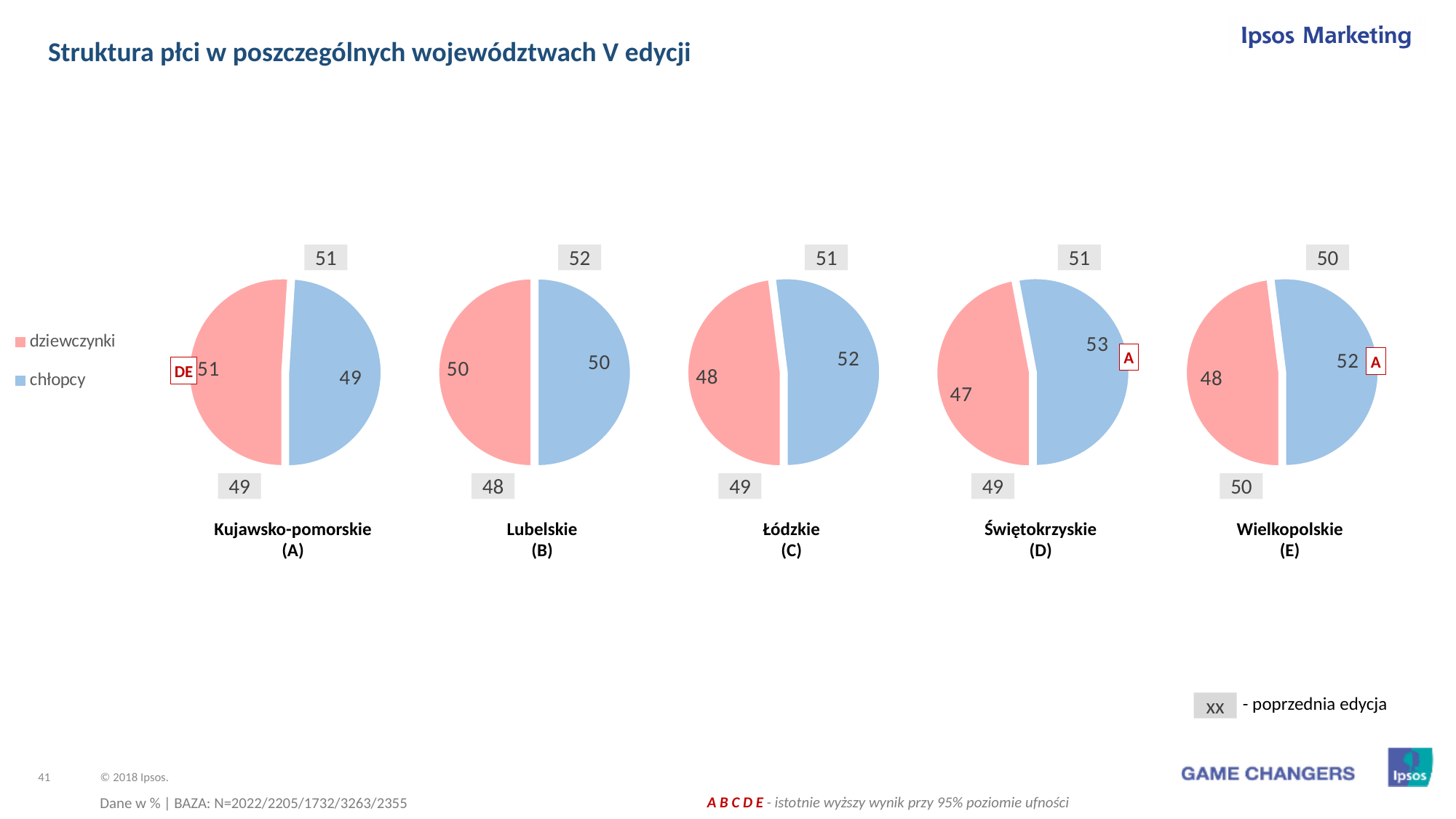
In the Wielkopolskie (E) pie chart, what is the value for chłopcy? 52 What kind of chart is used for each voivodeship on this slide? pie chart In the Kujawsko-pomorskie (A) pie chart, what is the value for dziewczynki? 51 Across the five pie charts, which voivodeship has the lowest value for dziewczynki? Świętokrzyskie (D) In the Świętokrzyskie (D) pie chart, what is the value for chłopcy? 53 How many pie charts are shown on the slide? 5 In the Lubelskie (B) pie chart, what is the value for chłopcy? 50 In the Świętokrzyskie (D) pie chart, what is the difference between the chłopcy and dziewczynki values? 6 Which colour represents dziewczynki in the pie charts? pink Across the five pie charts, which voivodeship has the highest value for chłopcy? Świętokrzyskie (D) How many series does the legend list? 2 In the Łódzkie (C) pie chart, what is the value for dziewczynki? 48